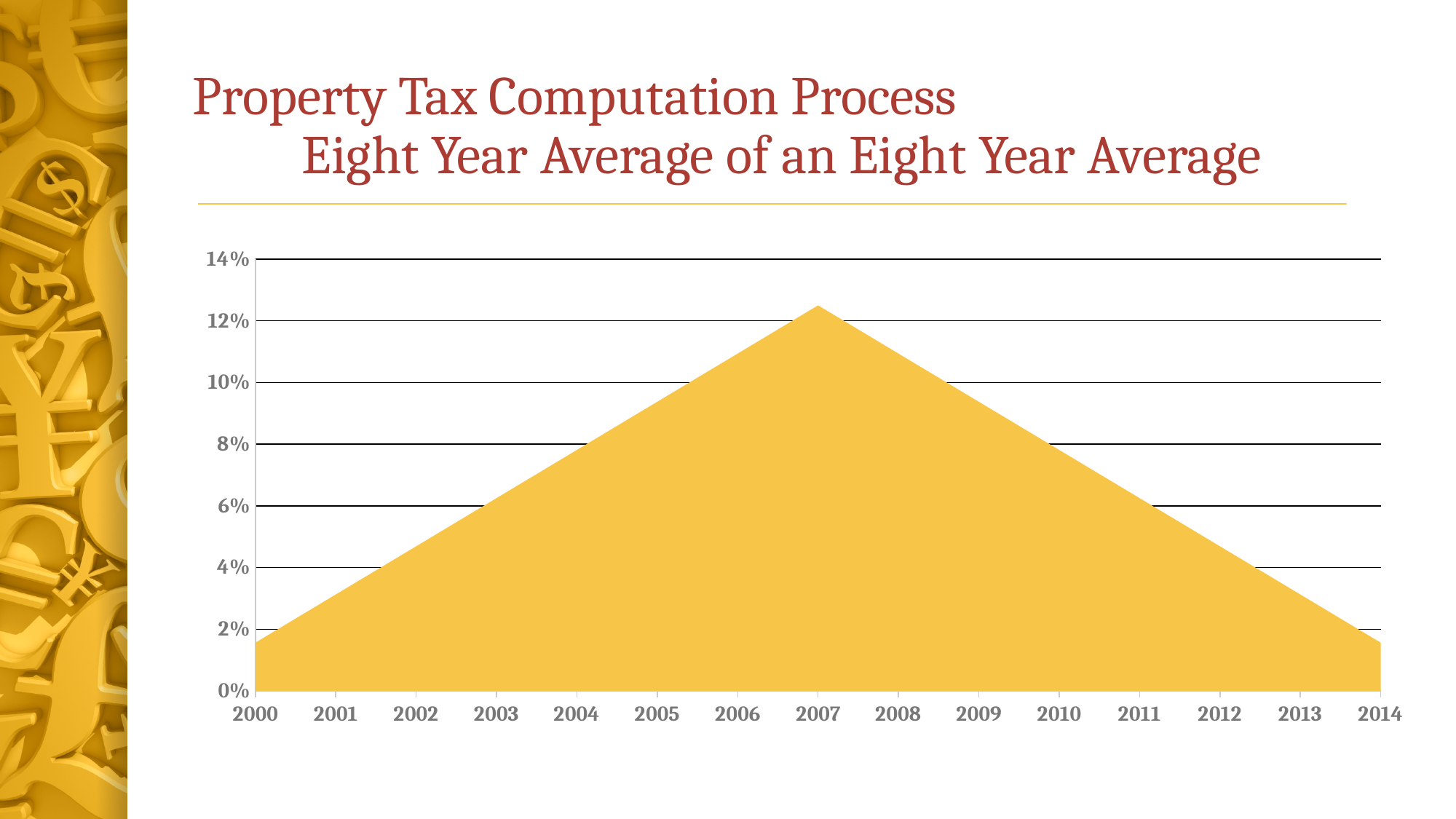
How many years are shown along the x axis of the chart? 15 Which year has the larger value, 2005 or 2012? 2005 Is the value for 2013 greater or less than 4%? less What is the title of the slide containing the chart? Property Tax Computation Process Eight Year Average of an Eight Year Average Is the value for 2010 greater or less than 6%? greater Is the value for 2007 greater or less than 10%? greater Which year has the highest value in the chart? 2007 How do the values change from 2000 to 2014? They rise until 2007, then fall Which year has the larger value, 2003 or 2010? 2010 What kind of chart is shown on the slide? Area chart